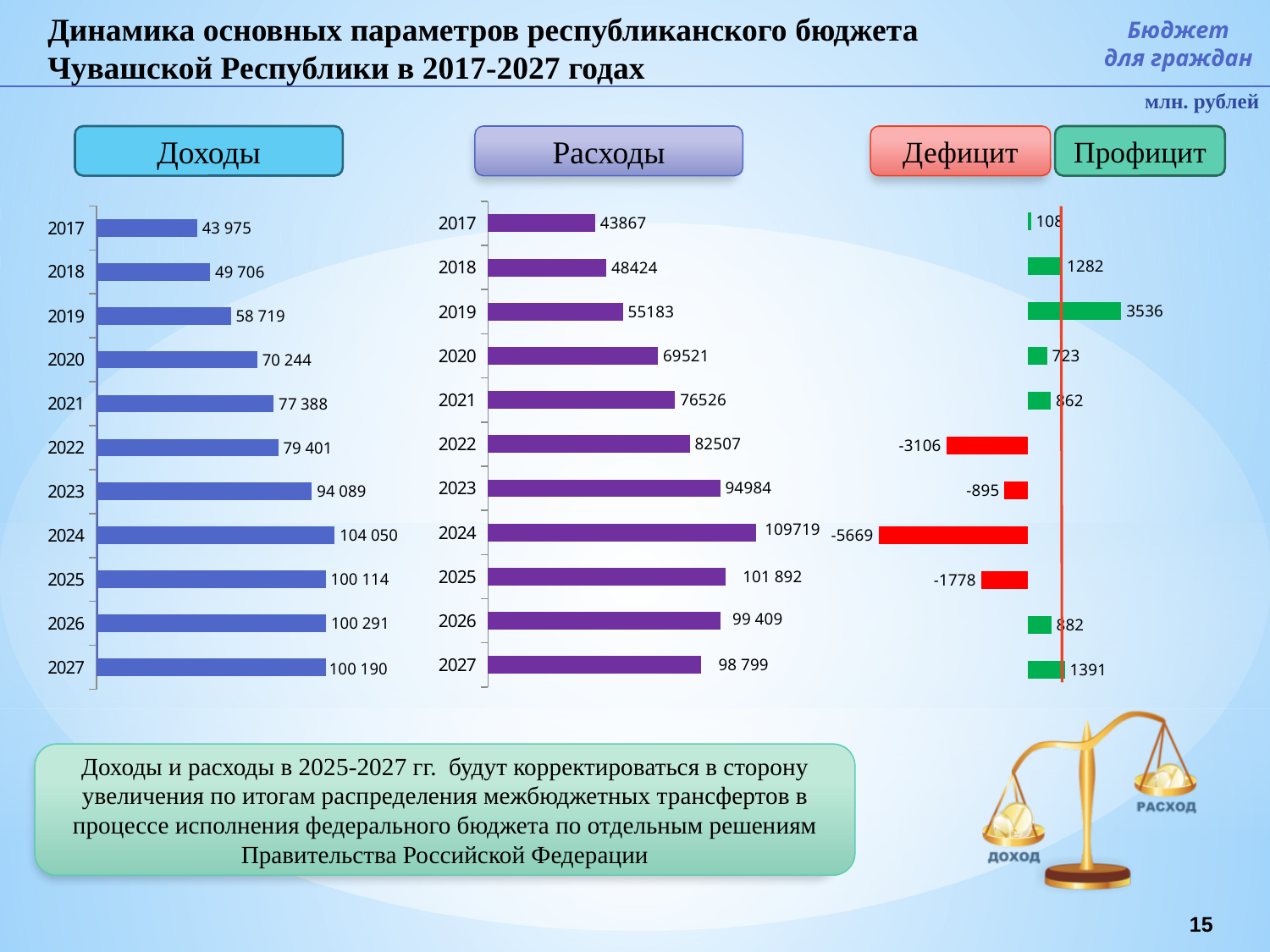
In the Доходы chart, which year has the highest value? 2024 In the Расходы chart, what is the value for 2024? 109719 What unit of measurement is stated for the charts on the slide? млн. рублей In the Дефицит/Профицит chart, which year has the lowest value? 2024 How many years are shown in the Доходы chart? 11 In the Дефицит/Профицит chart, what is the value for 2019? 3536 In the Расходы chart, do the values rise or fall from 2017 to 2024? Rise In the Доходы chart, which is larger: the value for 2025 or the value for 2026? 2026 In the Доходы chart, what is the value for 2020? 70 244 What type of chart is the Расходы chart? Bar chart In the Расходы chart, what is the difference between the values for 2024 and 2023? 14735 In the Расходы chart, which year has the lowest value? 2017